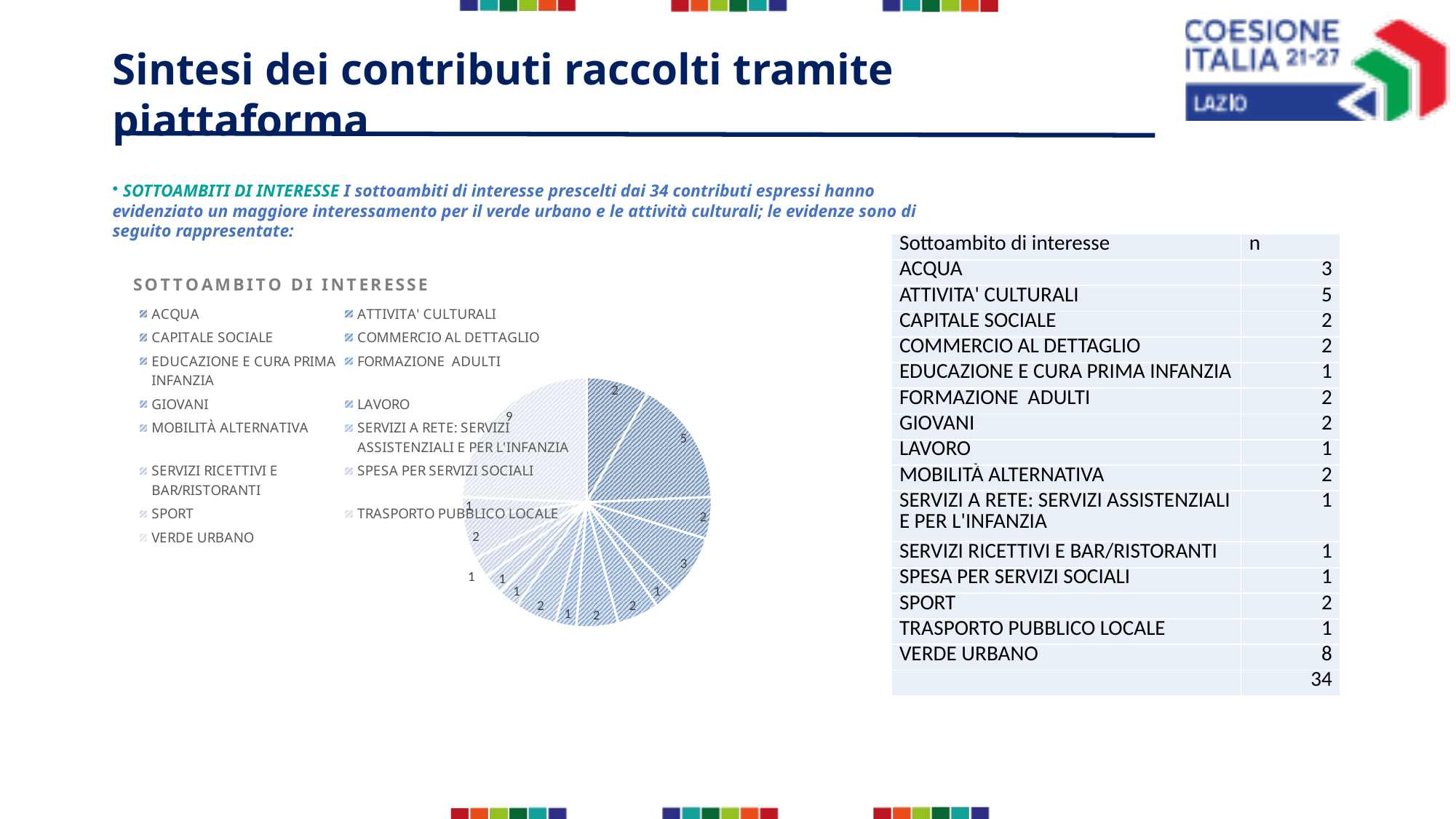
What is the title of the chart? SOTTOAMBITO DI INTERESSE What kind of chart is shown on the slide? pie chart Which is larger in the pie chart, VERDE URBANO or ATTIVITA' CULTURALI? VERDE URBANO Which is larger in the pie chart, ATTIVITA' CULTURALI or CAPITALE SOCIALE? ATTIVITA' CULTURALI What is the value shown for ATTIVITA' CULTURALI in the pie chart? 5 Is the legend entry for SPORT listed in the chart's legend? yes How many categories does the chart's legend list? 15 Which category has the largest slice in the pie chart? VERDE URBANO